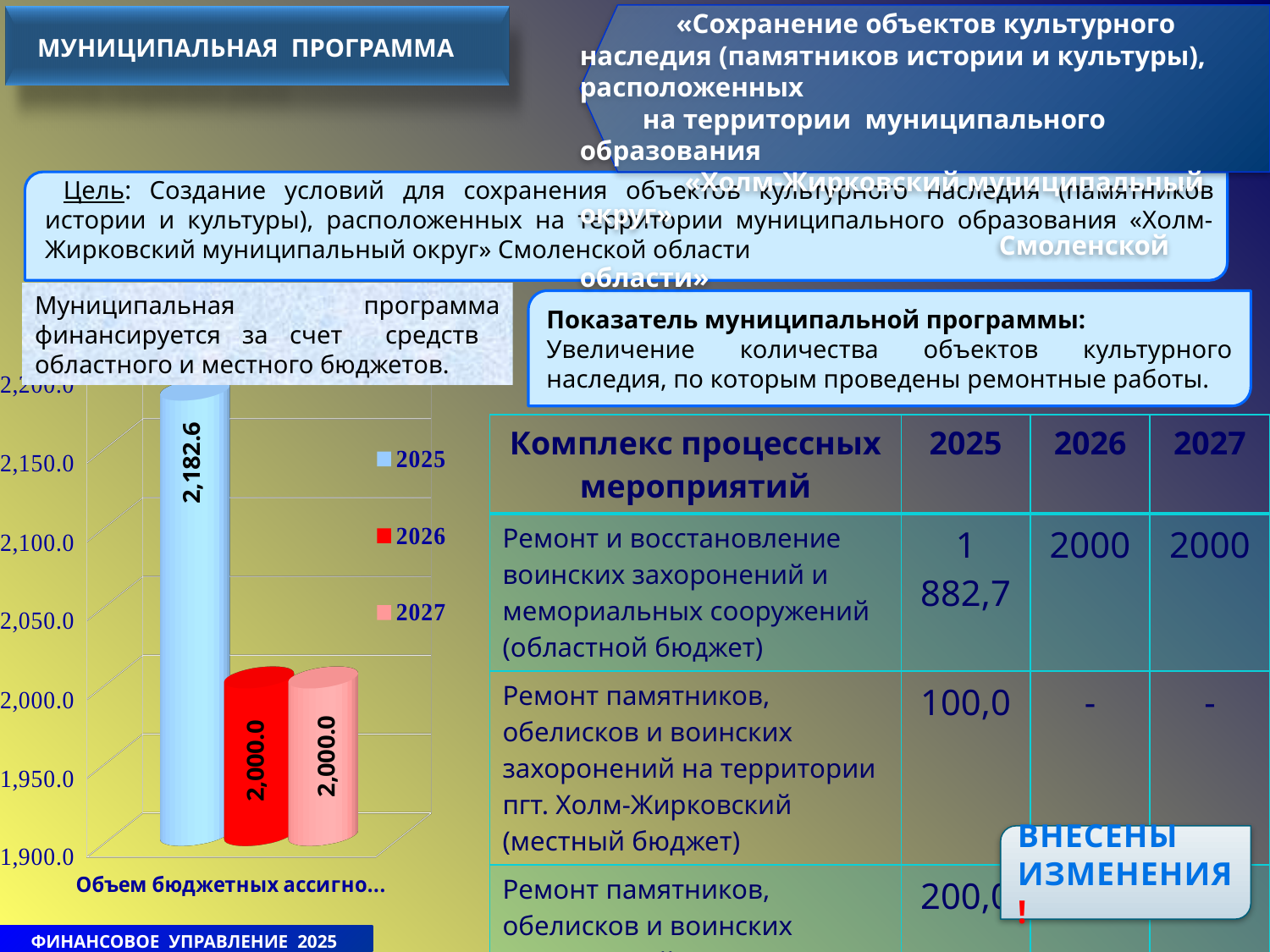
What is the value for 2027 in the chart? 2,000.0 How many bars are plotted in the chart? 3 Which is larger, the value for 2025 or the value for 2027? 2025 Which year has the highest value in the chart? 2025 What colour is the bar for 2026 in the chart? red Is the value for 2025 greater or less than 2,150.0? greater How many series does the chart legend list? 3 Is the value for 2026 greater or less than 2,100.0? less What is the difference between the 2025 value and the 2026 value? 182.6 What is the value for 2026 in the chart? 2,000.0 What is the value for 2025 in the chart? 2,182.6 What kind of chart is shown on the slide? bar chart